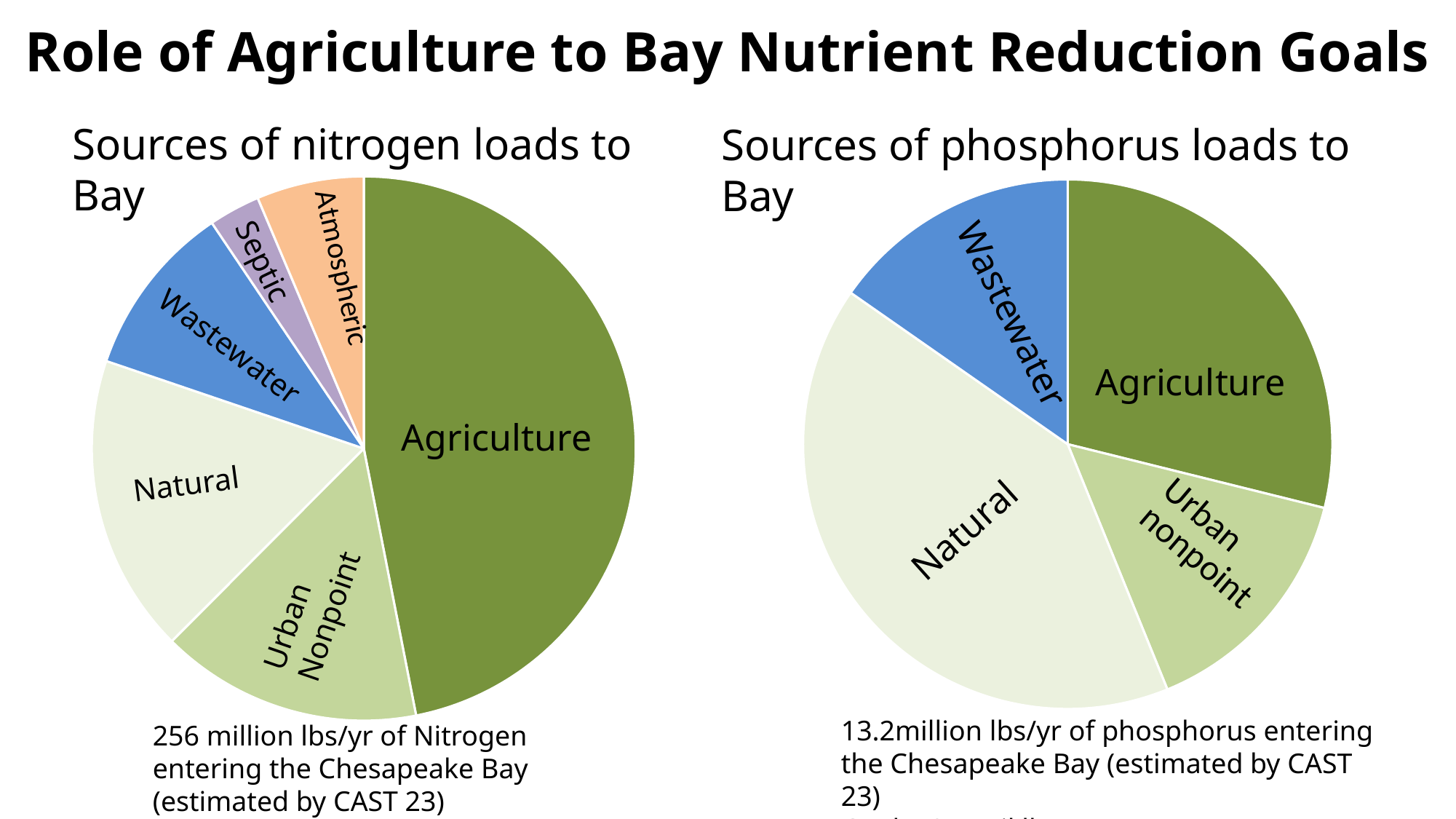
In the 'Sources of phosphorus loads to Bay' chart, how many slices are there? 4 In the 'Sources of nitrogen loads to Bay' chart, which source has the smallest slice? Septic In the 'Sources of nitrogen loads to Bay' chart, which slice is larger: Natural or Wastewater? Natural In the 'Sources of nitrogen loads to Bay' chart, which slice is larger: Atmospheric or Septic? Atmospheric What type of chart is the 'Sources of phosphorus loads to Bay' chart? pie chart What type of chart is the 'Sources of nitrogen loads to Bay' chart? pie chart According to the text under the phosphorus chart, how much phosphorus enters the Chesapeake Bay per year? 13.2million lbs/yr In the 'Sources of phosphorus loads to Bay' chart, which slice is larger: Agriculture or Wastewater? Agriculture In the 'Sources of phosphorus loads to Bay' chart, which source has the largest slice? Natural In the 'Sources of nitrogen loads to Bay' chart, which source has the largest slice? Agriculture According to the text under the nitrogen chart, how much nitrogen enters the Chesapeake Bay per year? 256 million lbs/yr In the 'Sources of nitrogen loads to Bay' chart, how many slices are there? 6